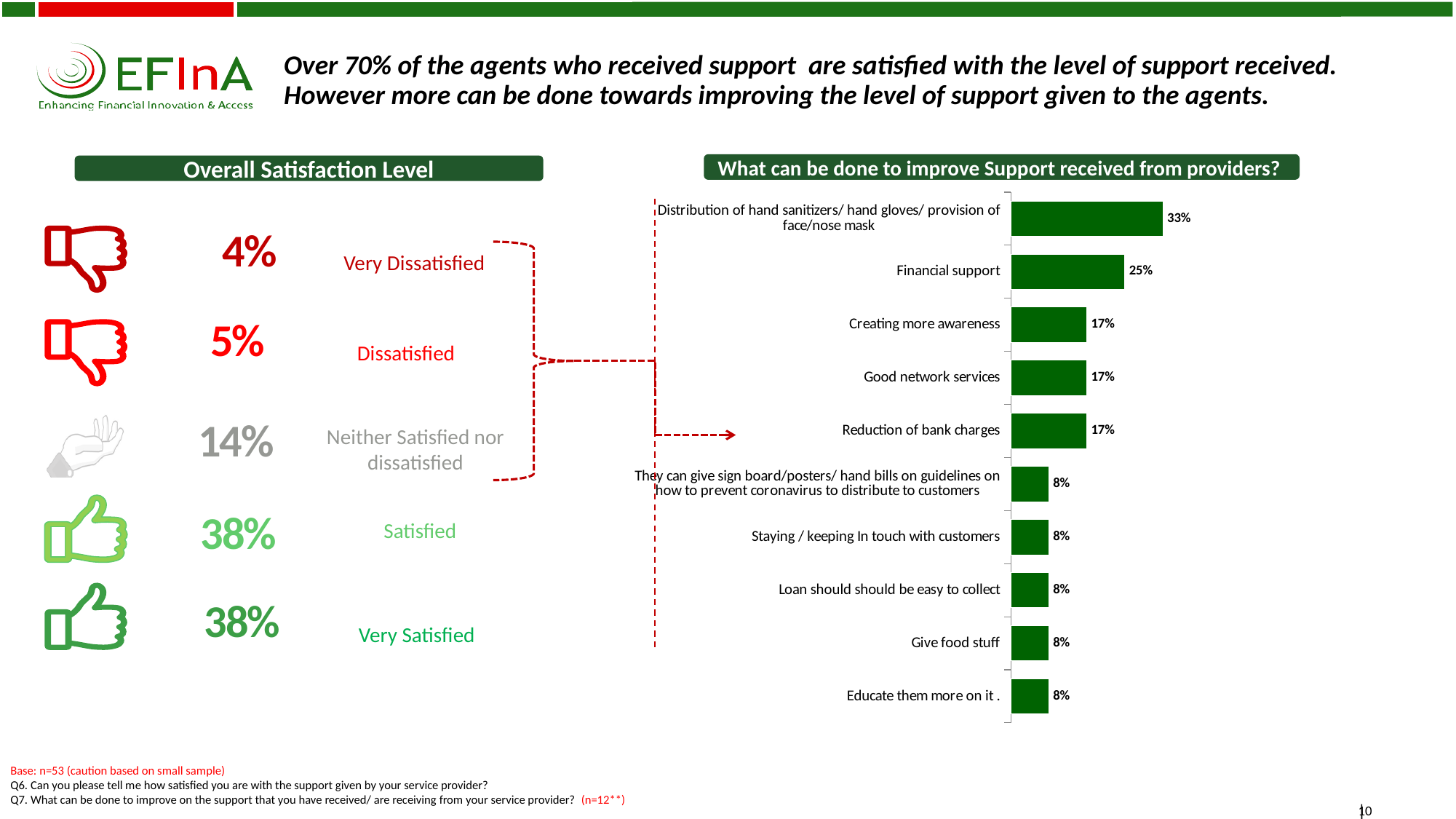
In the chart 'What can be done to improve Support received from providers?', which is larger: Good network services or Staying / keeping In touch with customers? Good network services In the chart 'What can be done to improve Support received from providers?', what value is shown for Distribution of hand sanitizers/ hand gloves/ provision of face/nose mask? 33% In the chart 'What can be done to improve Support received from providers?', what is the difference between the values for Distribution of hand sanitizers/ hand gloves/ provision of face/nose mask and Financial support? 8% In the chart 'What can be done to improve Support received from providers?', how many categories have a value of 8%? 5 In the chart 'What can be done to improve Support received from providers?', what value is shown for Give food stuff? 8% What type of chart is 'What can be done to improve Support received from providers?'? Bar chart In the chart 'What can be done to improve Support received from providers?', what is the difference between Financial support and Creating more awareness? 8% How many categories are plotted in the chart 'What can be done to improve Support received from providers?'? 10 In the chart 'What can be done to improve Support received from providers?', how many categories have a value of 17%? 3 In the chart 'What can be done to improve Support received from providers?', which category has the highest value? Distribution of hand sanitizers/ hand gloves/ provision of face/nose mask In the chart 'What can be done to improve Support received from providers?', what percentage is shown for Reduction of bank charges? 17% In the chart 'What can be done to improve Support received from providers?', what percentage is shown for Financial support? 25%